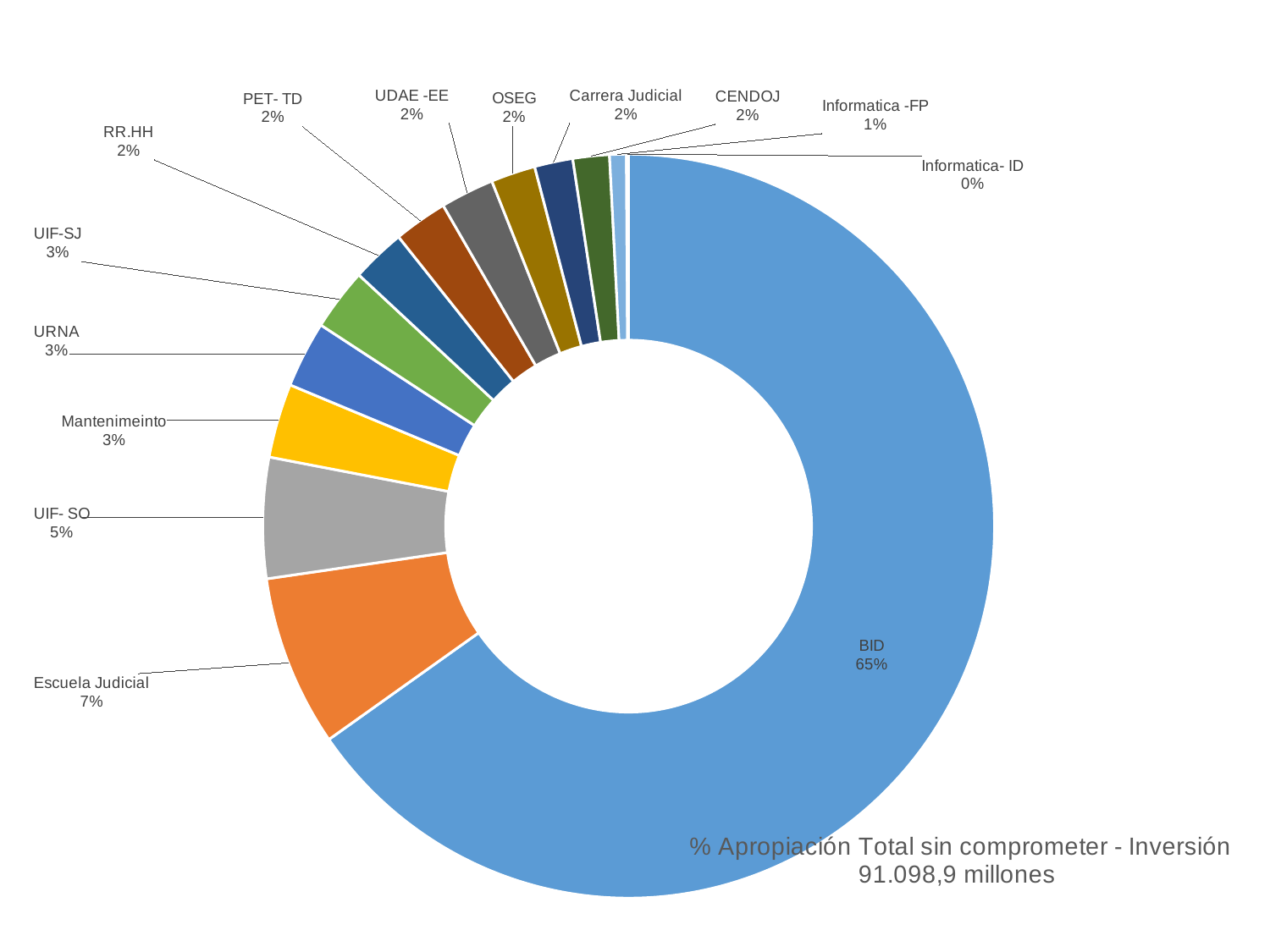
What percentage is shown for Informatica- ID? 0% What percentage is shown for UIF- SO? 5% How many categories are shown in the chart? 14 What percentage is shown for Escuela Judicial? 7% What is the difference in percentage points between BID and Escuela Judicial? 58 Which is larger, the share for Escuela Judicial or the share for UIF- SO? Escuela Judicial Which category has the largest share of the chart? BID What share of the chart does BID account for? 65% What total amount is stated in the chart title? 91.098,9 millones What kind of chart is shown on the slide? doughnut chart What percentage is shown for Informatica -FP? 1% Which category has the smallest share of the chart? Informatica- ID